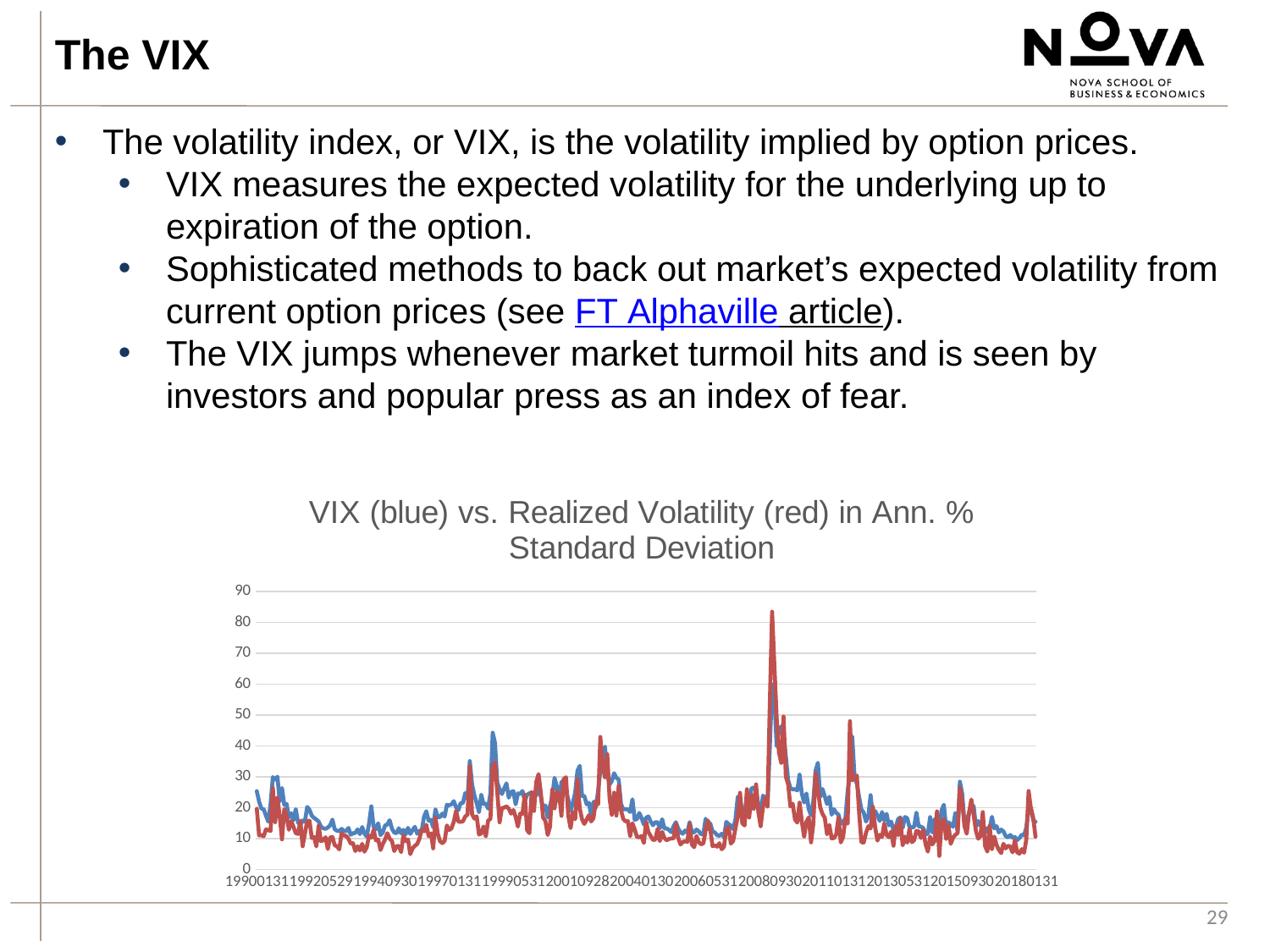
Is the value of the blue line at the start of the series (19900131) greater or less than 40? less Which colour represents the VIX in the chart? blue Is the highest peak of the red line greater or less than 70? greater What is the title of the chart? VIX (blue) vs. Realized Volatility (red) in Ann. % Standard Deviation What is the first date label shown on the x axis? 19900131 What kind of chart is shown on the slide? line chart Near which x-axis date label does the largest spike in both lines occur? 20080930 Is the value of the blue line at the end of the series (20180131) greater or less than 30? less How many series are plotted in the chart? 2 What is the lowest value shown on the y axis of the chart? 0 What is the highest value shown on the y axis of the chart? 90